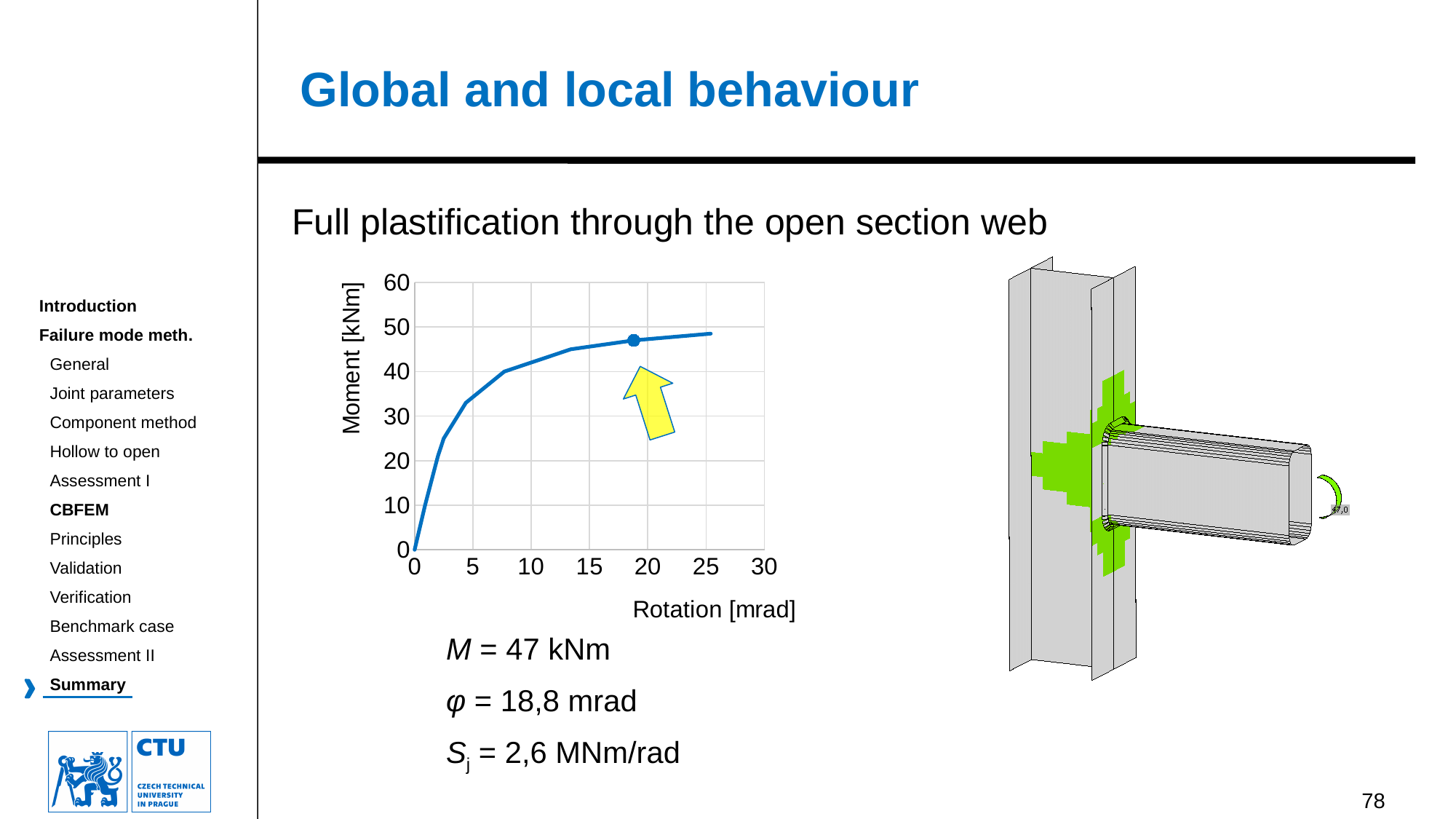
What is the highest value shown on the vertical axis of the chart? 60 What is the rotation φ at the marked point on the curve? 18,8 mrad What kind of chart is shown on the slide? line chart What is the label of the vertical axis of the chart? Moment [kNm] Does the moment rise or fall as rotation increases along the x axis? rise Is the moment at a rotation of 15 mrad greater or less than 40? greater How many data series are plotted on the chart? 1 What is the moment M at the marked point on the curve? 47 kNm What is the label of the horizontal axis of the chart? Rotation [mrad] Is the moment at a rotation of 5 mrad greater or less than 30? greater